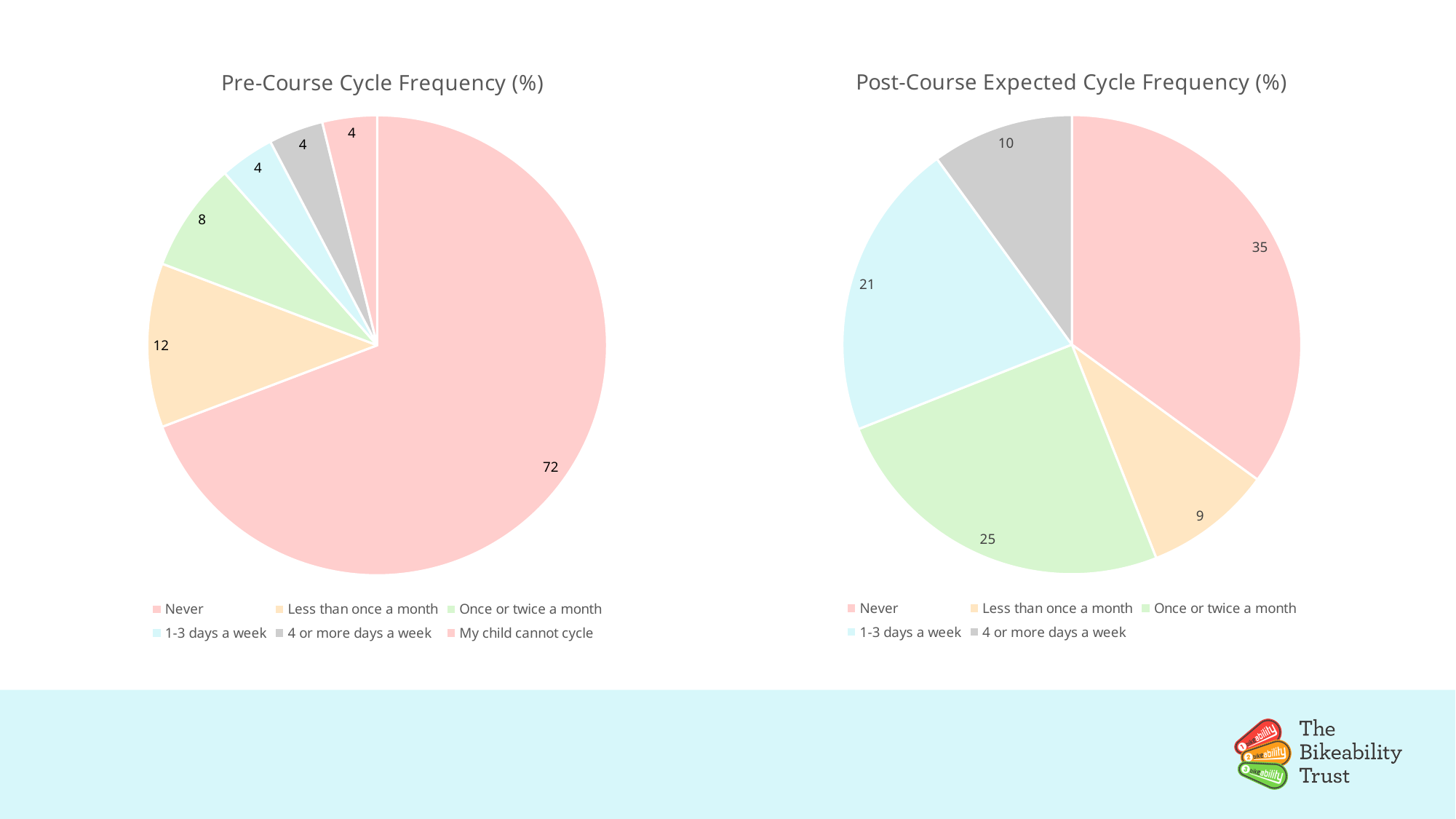
In the Post-Course Expected Cycle Frequency (%) chart, which category has the largest slice? Never How many slices does the Pre-Course Cycle Frequency (%) chart have? 6 How many categories does the legend of the Post-Course Expected Cycle Frequency (%) chart list? 5 In the Pre-Course Cycle Frequency (%) chart, what is the value for Less than once a month? 12 In the Pre-Course Cycle Frequency (%) chart, what is the value for Never? 72 In the Post-Course Expected Cycle Frequency (%) chart, which is larger: Once or twice a month or 1-3 days a week? Once or twice a month What type of chart is the Pre-Course Cycle Frequency (%) chart? Pie chart In the Post-Course Expected Cycle Frequency (%) chart, which category has the smallest slice? Less than once a month What is the difference between the Never value in the Pre-Course Cycle Frequency (%) chart and the Never value in the Post-Course Expected Cycle Frequency (%) chart? 37 In the Post-Course Expected Cycle Frequency (%) chart, what is the value for 1-3 days a week? 21 In the Post-Course Expected Cycle Frequency (%) chart, what is the value for Once or twice a month? 25 In the Pre-Course Cycle Frequency (%) chart, which category has the largest slice? Never